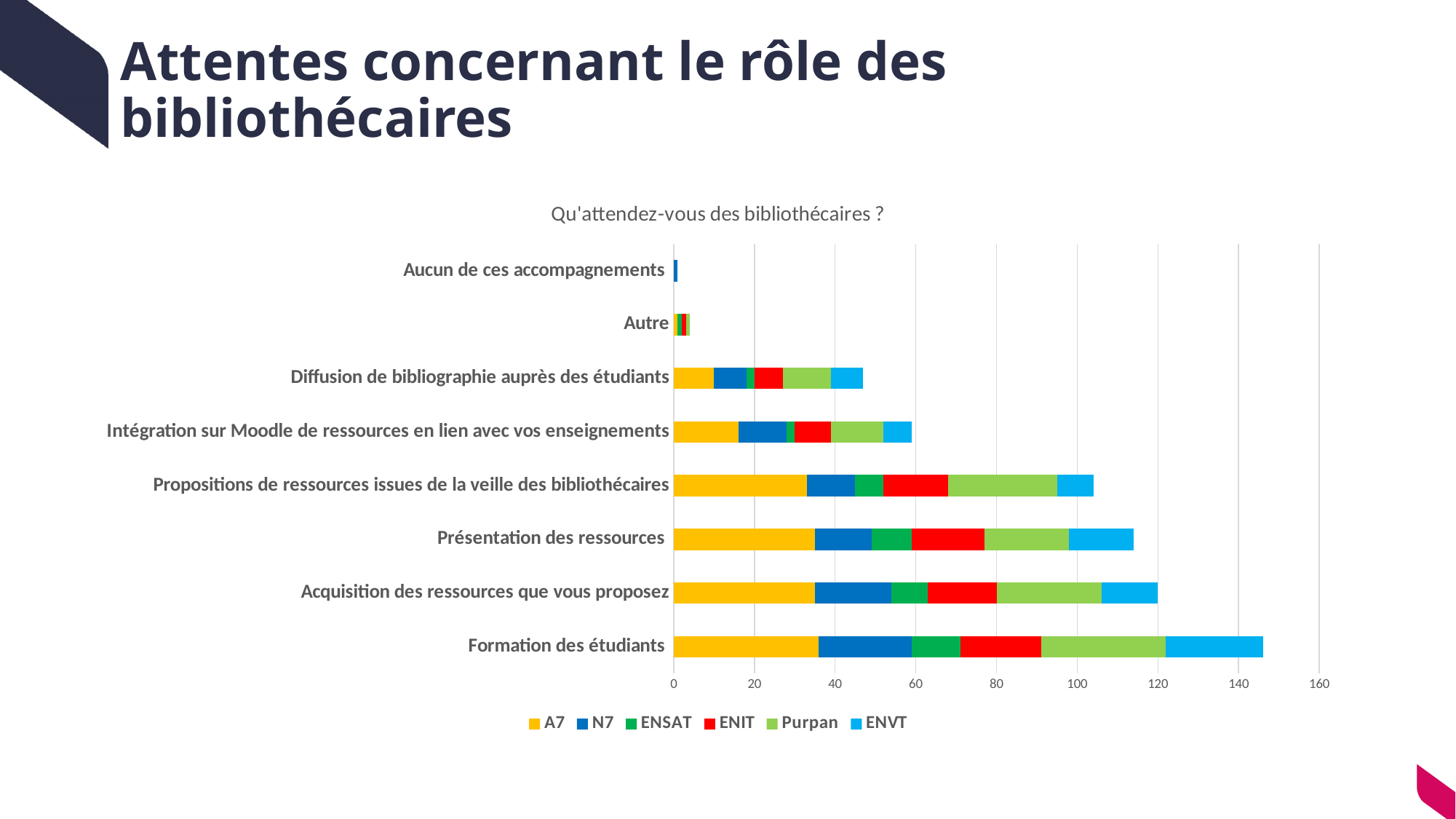
Which series is shown in red in the legend? ENIT Is the total bar for Formation des étudiants greater or less than 140? greater What kind of chart is shown on the slide? Stacked bar chart How many categories are plotted on the chart? 8 Which category has the longest total bar? Formation des étudiants Which has the longer total bar: Acquisition des ressources que vous proposez or Présentation des ressources? Acquisition des ressources que vous proposez Is the total bar for Propositions de ressources issues de la veille des bibliothécaires greater or less than 120? less Is the total bar for Diffusion de bibliographie auprès des étudiants greater or less than 60? less How many series does the legend list? 6 Which category has the shortest total bar? Aucun de ces accompagnements What is the title of the chart? Qu'attendez-vous des bibliothécaires ?